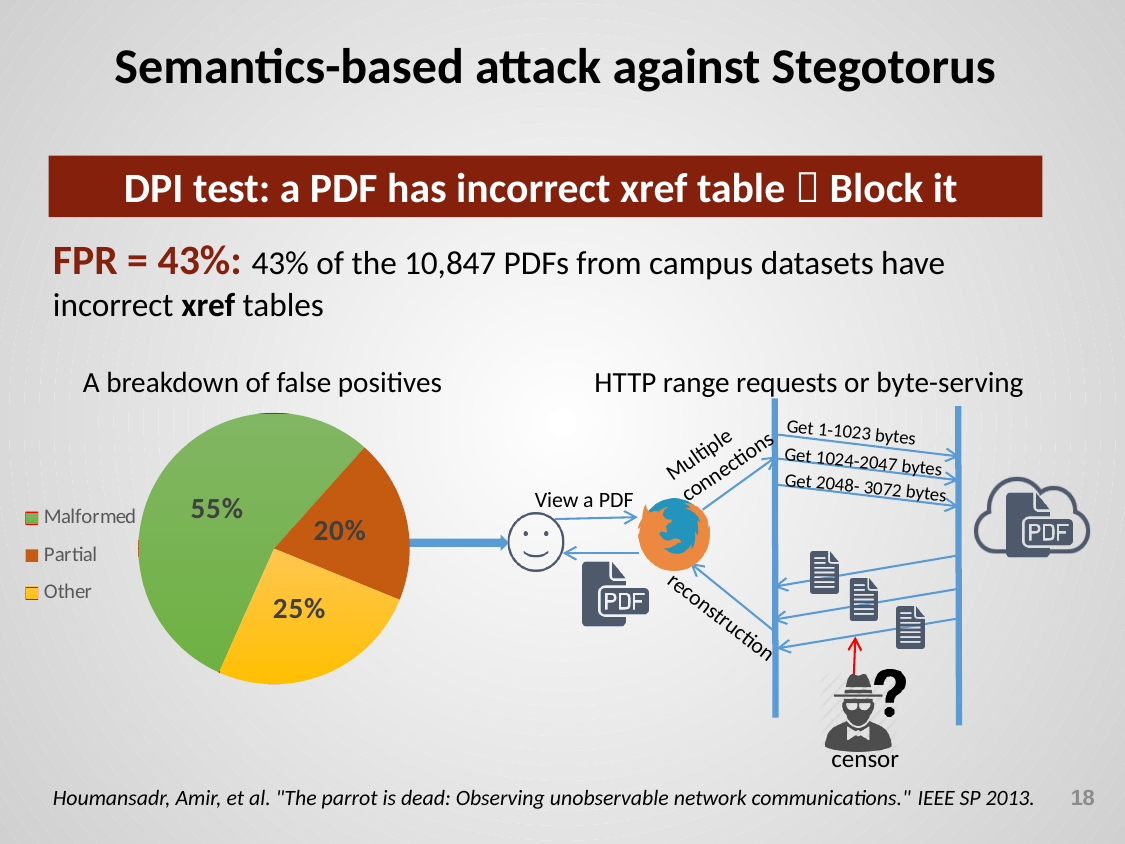
What is the title of the pie chart? A breakdown of false positives Which category has the largest slice in the pie chart? Malformed What kind of chart is shown under the heading "A breakdown of false positives"? pie chart How many entries does the legend of the pie chart list? 3 What share of false positives is labelled Other in the pie chart? 25% What share of false positives is labelled Malformed in the pie chart? 55% Which category has the smallest slice in the pie chart? Partial What colour is the Malformed slice in the pie chart? green How many categories does the pie chart show? 3 In the pie chart, which is larger: the Other slice or the Partial slice? Other What is the difference in percentage points between the Malformed and Other slices in the pie chart? 30% What share of false positives is labelled Partial in the pie chart? 20%